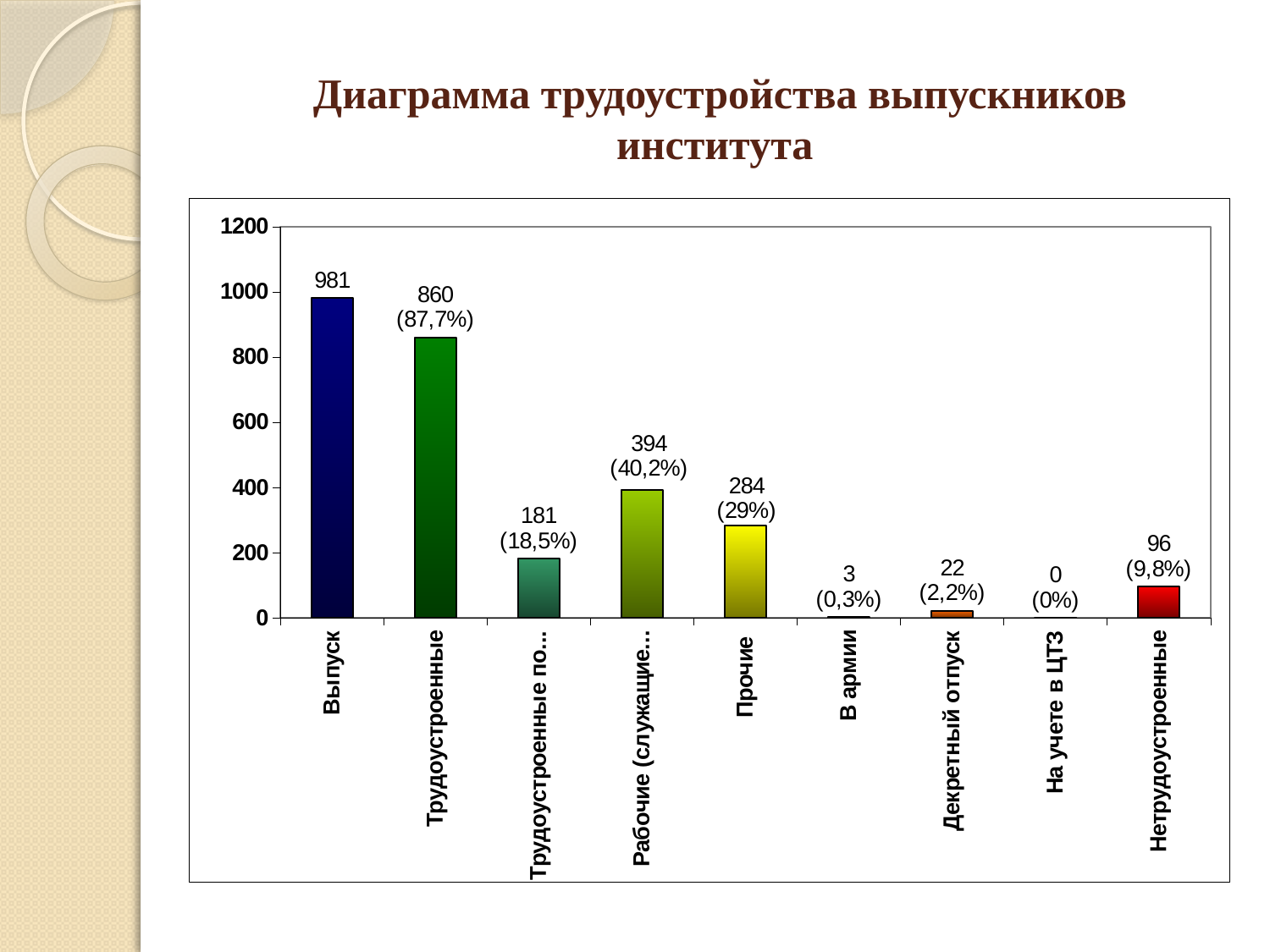
What is the value for Трудоустроенные? 860 How many categories are plotted on the chart? 9 What is the difference between the values for Выпуск and Трудоустроенные? 121 What kind of chart is shown on the slide? bar chart What percentage is shown for Нетрудоустроенные? 9,8% Which category has the lowest value? На учете в ЦТЗ What is the title of the slide? Диаграмма трудоустройства выпускников института What is the value for Прочие? 284 Which is larger, the value for Прочие or the value for Нетрудоустроенные? Прочие What is the value for Выпуск? 981 Which category has the highest value? Выпуск What is the value for Декретный отпуск? 22